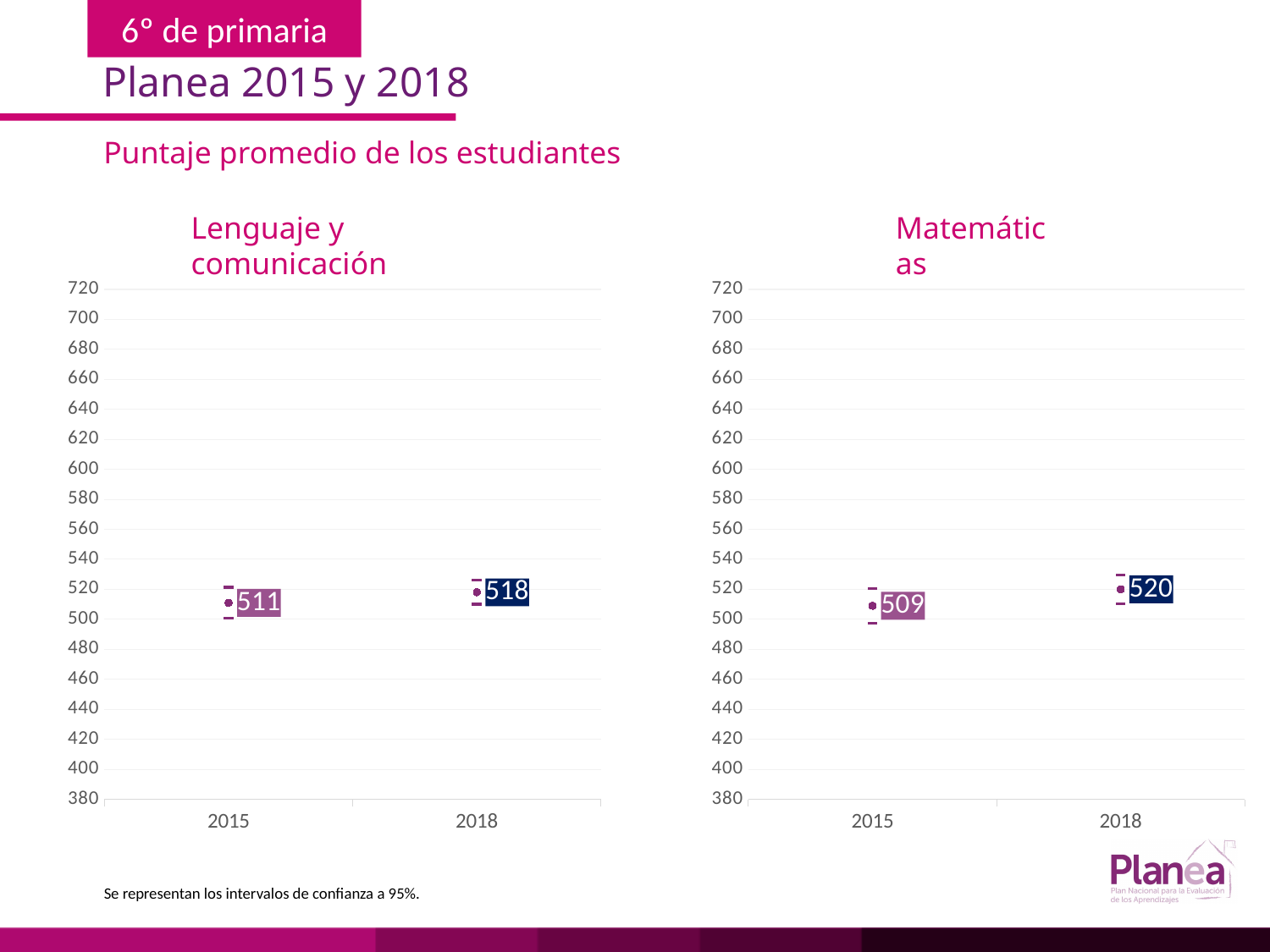
In the 'Lenguaje y comunicación' chart, what is the value for 2015? 511 In the 'Lenguaje y comunicación' chart, which year has the lowest value? 2015 In the 'Lenguaje y comunicación' chart, do the values rise or fall from 2015 to 2018? rise In the 'Matemáticas' chart, which year has the higher value, 2015 or 2018? 2018 In the 'Lenguaje y comunicación' chart, what is the difference between the 2018 and 2015 values? 7 In the 'Matemáticas' chart, is the value for 2015 greater or less than 520? less What is the highest value shown on the vertical axis of the 'Lenguaje y comunicación' chart? 720 In the 'Matemáticas' chart, what is the value for 2015? 509 In the 'Matemáticas' chart, what is the value for 2018? 520 In the 'Matemáticas' chart, what is the difference between the 2018 and 2015 values? 11 In the 'Lenguaje y comunicación' chart, what is the value for 2018? 518 How many years are plotted in the 'Matemáticas' chart? 2